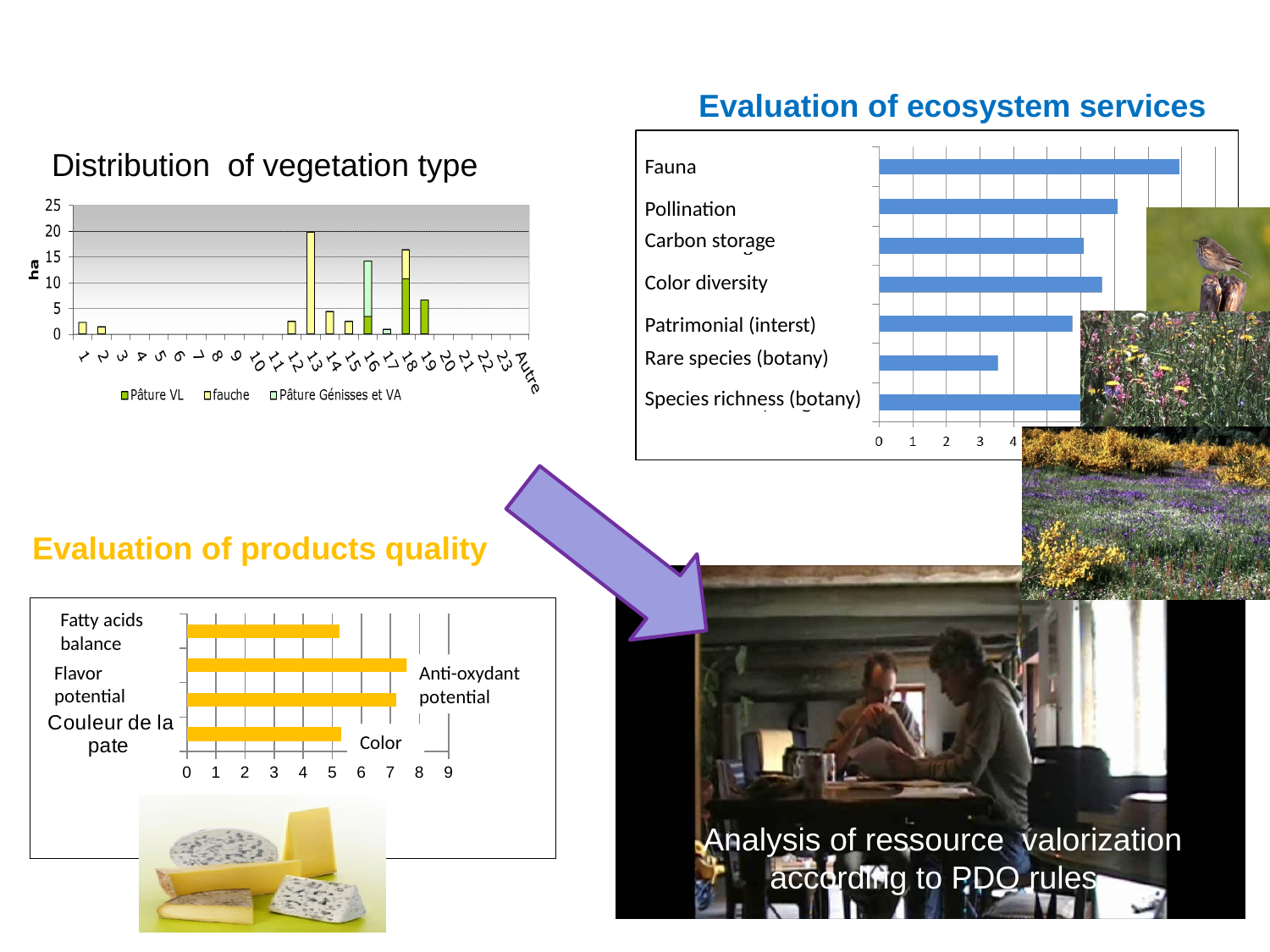
How many categories are shown in the "Evaluation of products quality" chart? 4 How many series does the legend of the "Distribution of vegetation type" chart list? 3 In the "Distribution of vegetation type" chart, which category has the tallest bar? 13 In the "Evaluation of products quality" chart, is the value for Fatty acids balance greater or less than 6? less In the "Evaluation of ecosystem services" chart, which category has the shortest bar? Rare species (botany) In the "Distribution of vegetation type" chart, is the value for category 13 greater or less than 15? greater What kind of chart is the "Distribution of vegetation type" chart? bar chart How many categories are shown in the "Evaluation of ecosystem services" chart? 7 What unit is shown on the vertical axis of the "Distribution of vegetation type" chart? ha In the "Evaluation of ecosystem services" chart, is the value for Rare species (botany) greater or less than 4? less In the "Evaluation of ecosystem services" chart, which category has the longest bar? Fauna